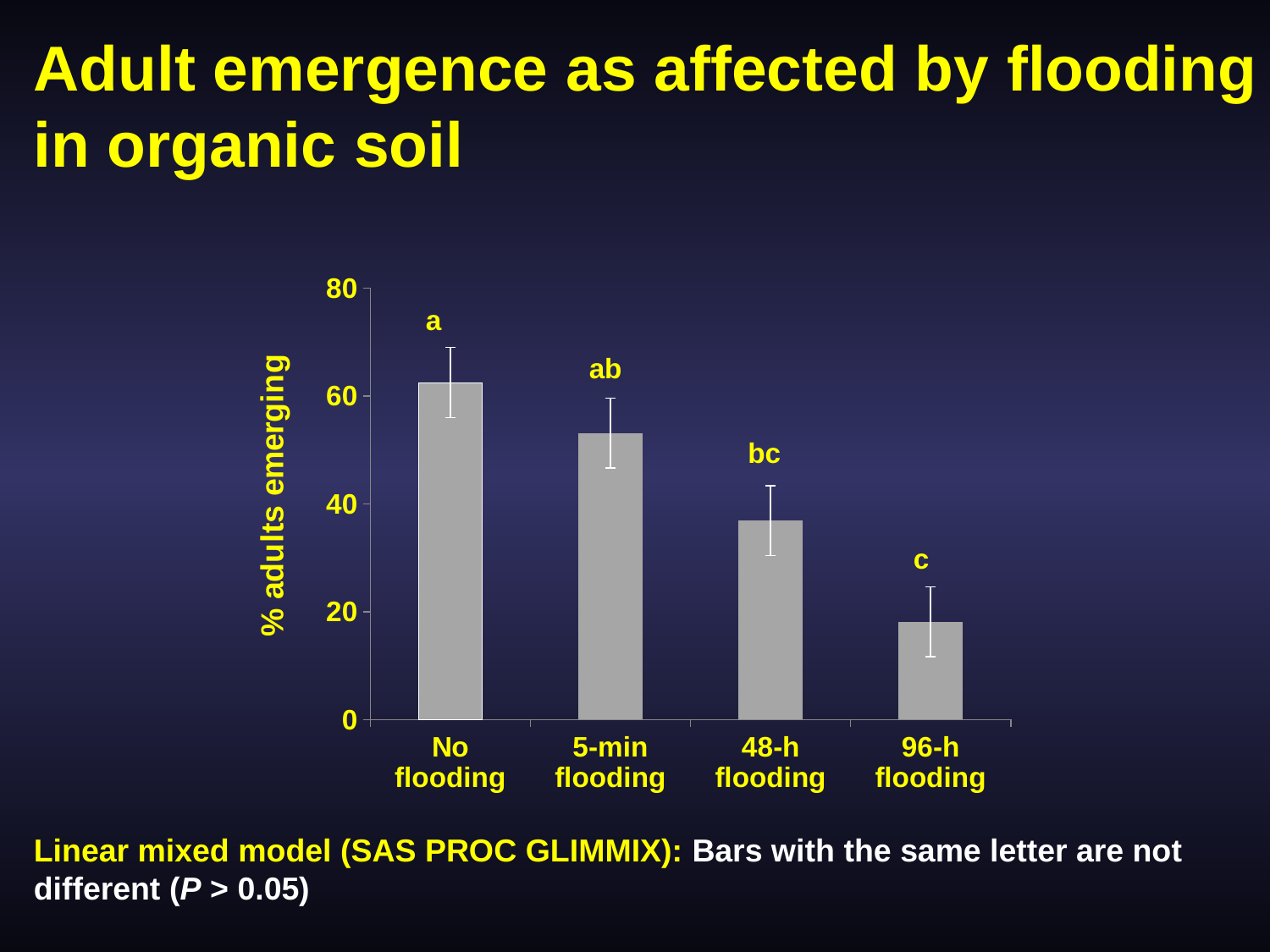
Is the value for 48-h flooding greater or less than 40? less Which treatment has the lowest percentage of adults emerging? 96-h flooding What letter is printed above the 48-h flooding bar? bc Is the value for 5-min flooding greater or less than 60? less What kind of chart is shown on the slide? bar chart Which treatment has the highest percentage of adults emerging? No flooding Is the value for No flooding greater or less than 60? greater What is the label of the y axis? % adults emerging Do the values rise or fall as flooding duration increases from left to right along the x axis? fall Which has a higher percentage of adults emerging, 5-min flooding or 48-h flooding? 5-min flooding How many flooding treatments (bars) are shown in the chart? 4